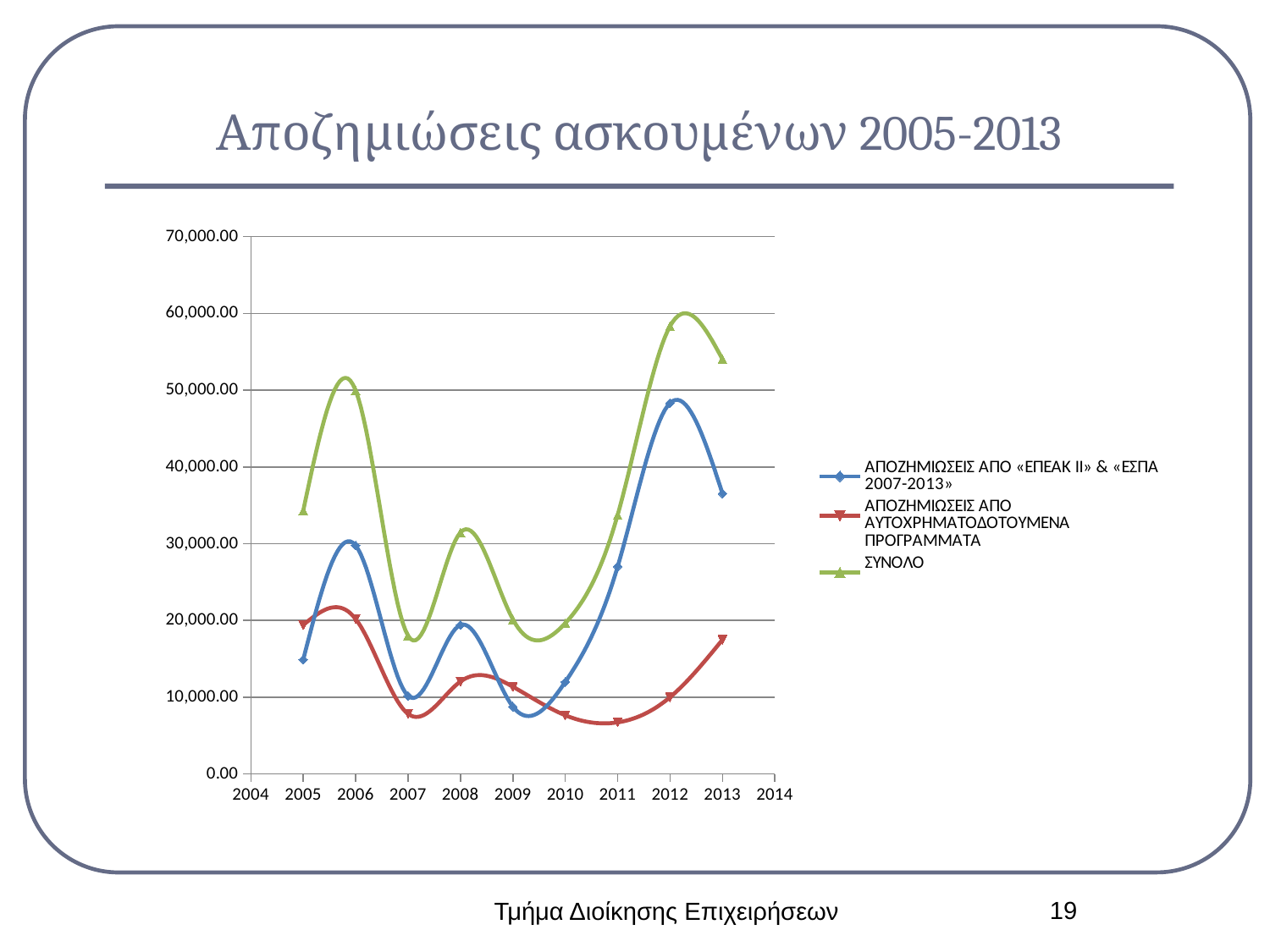
In which year is the ΣΥΝΟΛΟ series at its highest? 2012 In which year is the ΣΥΝΟΛΟ series at its lowest? 2007 Does the ΣΥΝΟΛΟ series rise or fall from 2010 to 2012? rise What is the title of the slide containing the chart? Αποζημιώσεις ασκουμένων 2005-2013 How many years have data points plotted on the chart? 9 Is the ΣΥΝΟΛΟ value for 2012 greater or less than 50,000.00? greater Is the value of the ΑΠΟΖΗΜΙΩΣΕΙΣ ΑΠΟ «ΕΠΕΑΚ ΙΙ» & «ΕΣΠΑ 2007-2013» series in 2009 greater or less than 10,000.00? less How many series does the legend list? 3 In which year is the ΑΠΟΖΗΜΙΩΣΕΙΣ ΑΠΟ ΑΥΤΟΧΡΗΜΑΤΟΔΟΤΟΥΜΕΝΑ ΠΡΟΓΡΑΜΜΑΤΑ series at its lowest? 2011 In which year does the ΑΠΟΖΗΜΙΩΣΕΙΣ ΑΠΟ «ΕΠΕΑΚ ΙΙ» & «ΕΣΠΑ 2007-2013» series reach its highest value? 2012 In 2005, which series is higher: ΑΠΟΖΗΜΙΩΣΕΙΣ ΑΠΟ «ΕΠΕΑΚ ΙΙ» & «ΕΣΠΑ 2007-2013» or ΑΠΟΖΗΜΙΩΣΕΙΣ ΑΠΟ ΑΥΤΟΧΡΗΜΑΤΟΔΟΤΟΥΜΕΝΑ ΠΡΟΓΡΑΜΜΑΤΑ? ΑΠΟΖΗΜΙΩΣΕΙΣ ΑΠΟ ΑΥΤΟΧΡΗΜΑΤΟΔΟΤΟΥΜΕΝΑ ΠΡΟΓΡΑΜΜΑΤΑ What kind of chart is shown on the slide? Line chart